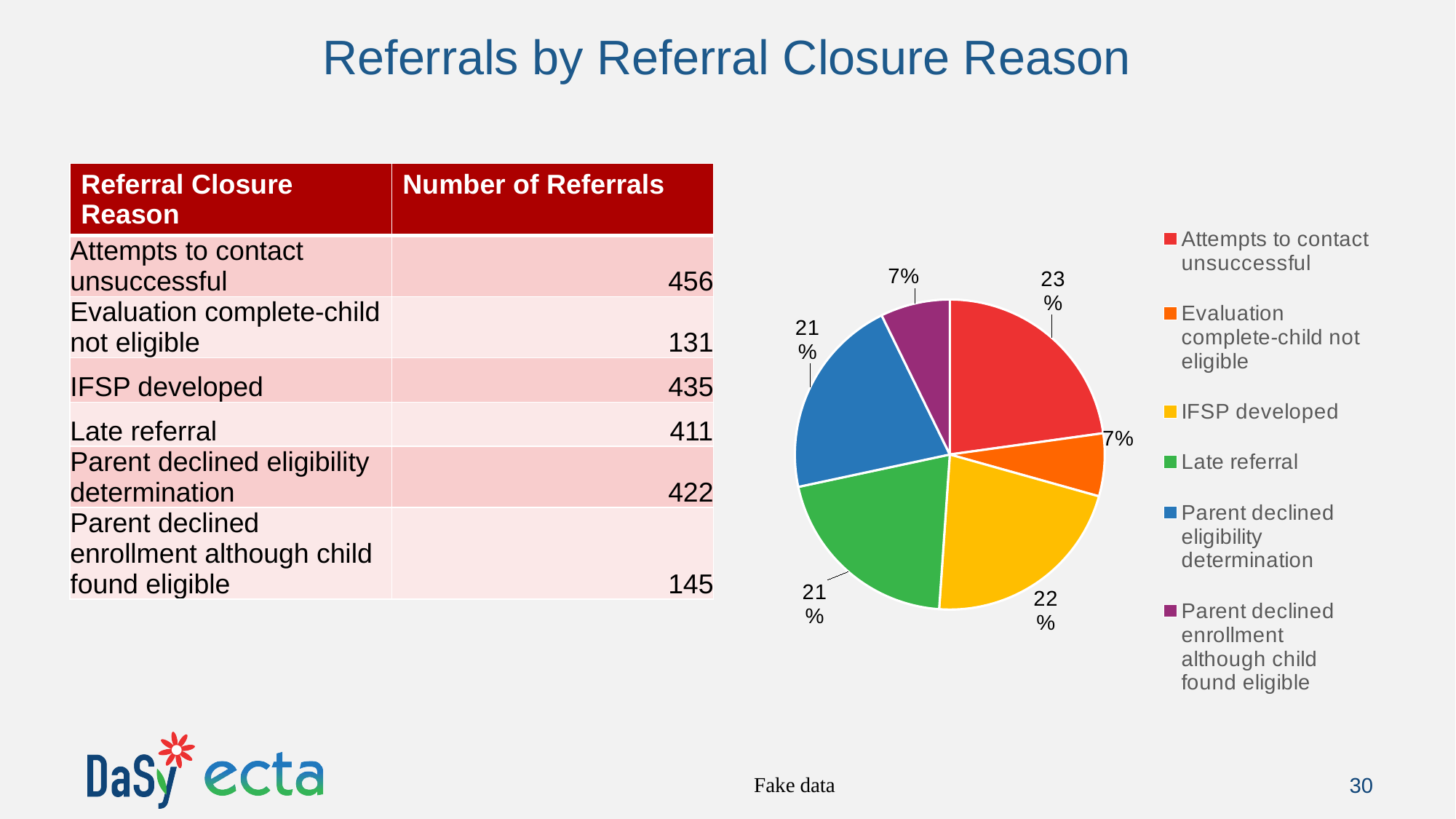
How many entries does the legend of the pie chart list? 6 What share of the pie does the 'Attempts to contact unsuccessful' slice represent? 23% What share of the pie does the 'Evaluation complete-child not eligible' slice represent? 7% What share of the pie does the 'Parent declined enrollment although child found eligible' slice represent? 7% Which slice is larger: 'Attempts to contact unsuccessful' or 'Evaluation complete-child not eligible'? Attempts to contact unsuccessful How many slices does the pie chart have? 6 What kind of chart is shown on the slide? pie chart What colour is the 'Late referral' slice in the pie chart? green By how many percentage points does the 'Attempts to contact unsuccessful' slice exceed the 'Evaluation complete-child not eligible' slice? 16 percentage points Which referral closure reason has the largest slice of the pie? Attempts to contact unsuccessful